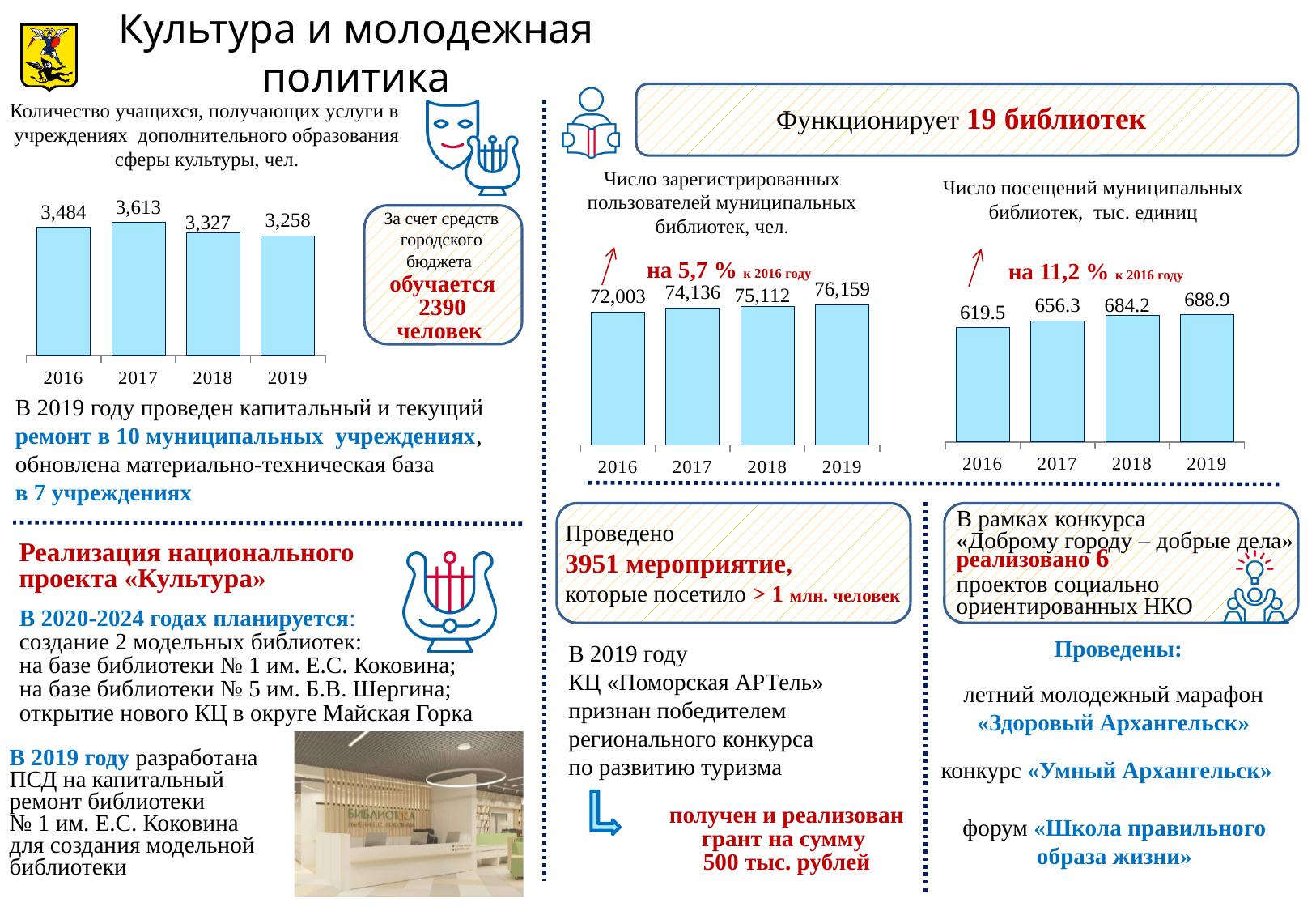
In the chart 'Число зарегистрированных пользователей муниципальных библиотек, чел.', what is the value for 2016? 72,003 What kind of chart is 'Число посещений муниципальных библиотек, тыс. единиц'? bar chart In the chart 'Число зарегистрированных пользователей муниципальных библиотек, чел.', do the values rise or fall from 2016 to 2019? rise In the chart 'Число посещений муниципальных библиотек, тыс. единиц', what is the value for 2018? 684.2 In the chart 'Число зарегистрированных пользователей муниципальных библиотек, чел.', which year has the highest value? 2019 In the chart 'Число посещений муниципальных библиотек, тыс. единиц', what is the difference between the 2019 and 2016 values? 69.4 In the chart 'Число посещений муниципальных библиотек, тыс. единиц', which is larger, the value for 2016 or the value for 2017? 2017 In the chart 'Число посещений муниципальных библиотек, тыс. единиц', how many years are shown? 4 In the chart 'Количество учащихся, получающих услуги в учреждениях дополнительного образования сферы культуры, чел.', what is the difference between the 2017 and 2019 values? 355 In the chart 'Количество учащихся, получающих услуги в учреждениях дополнительного образования сферы культуры, чел.', which year has the lowest value? 2019 In the chart 'Число зарегистрированных пользователей муниципальных библиотек, чел.', what is the difference between the 2019 and 2018 values? 1,047 In the chart 'Количество учащихся, получающих услуги в учреждениях дополнительного образования сферы культуры, чел.', what is the value for 2017? 3,613